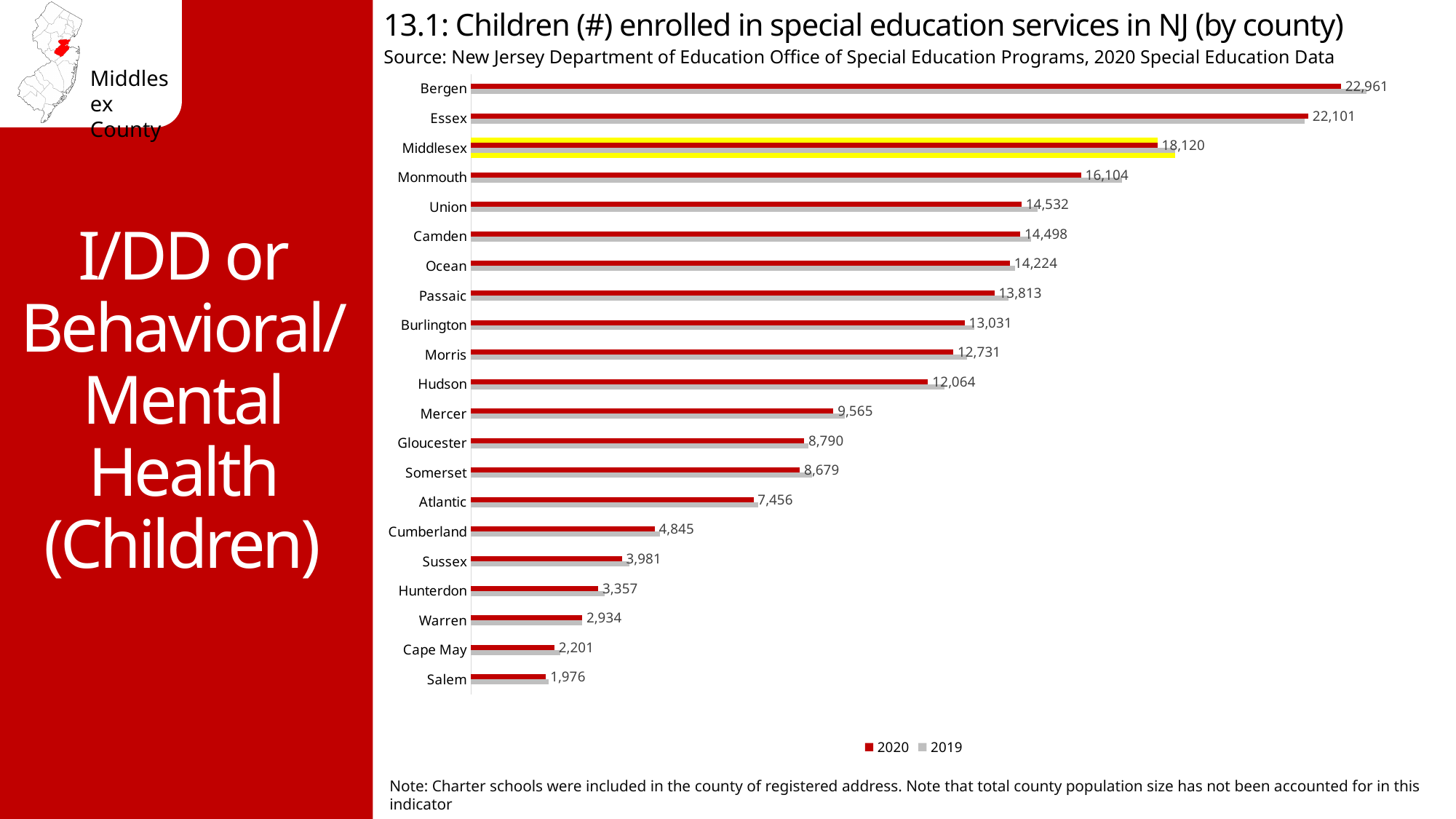
How many series does the legend list? 2 What is the difference between the 2020 values for Middlesex and Monmouth? 2,016 What is the 2020 value for Bergen? 22,961 What kind of chart is shown? Bar chart Which series is shown in red? 2020 Which has a larger 2020 value, Monmouth or Union? Monmouth What is the 2020 value for Middlesex? 18,120 What is the 2020 value for Cape May? 2,201 Which county has the lowest 2020 value? Salem What is the difference between the 2020 values for Bergen and Essex? 860 Which county has the highest 2020 value? Bergen How many counties are shown on the chart? 21